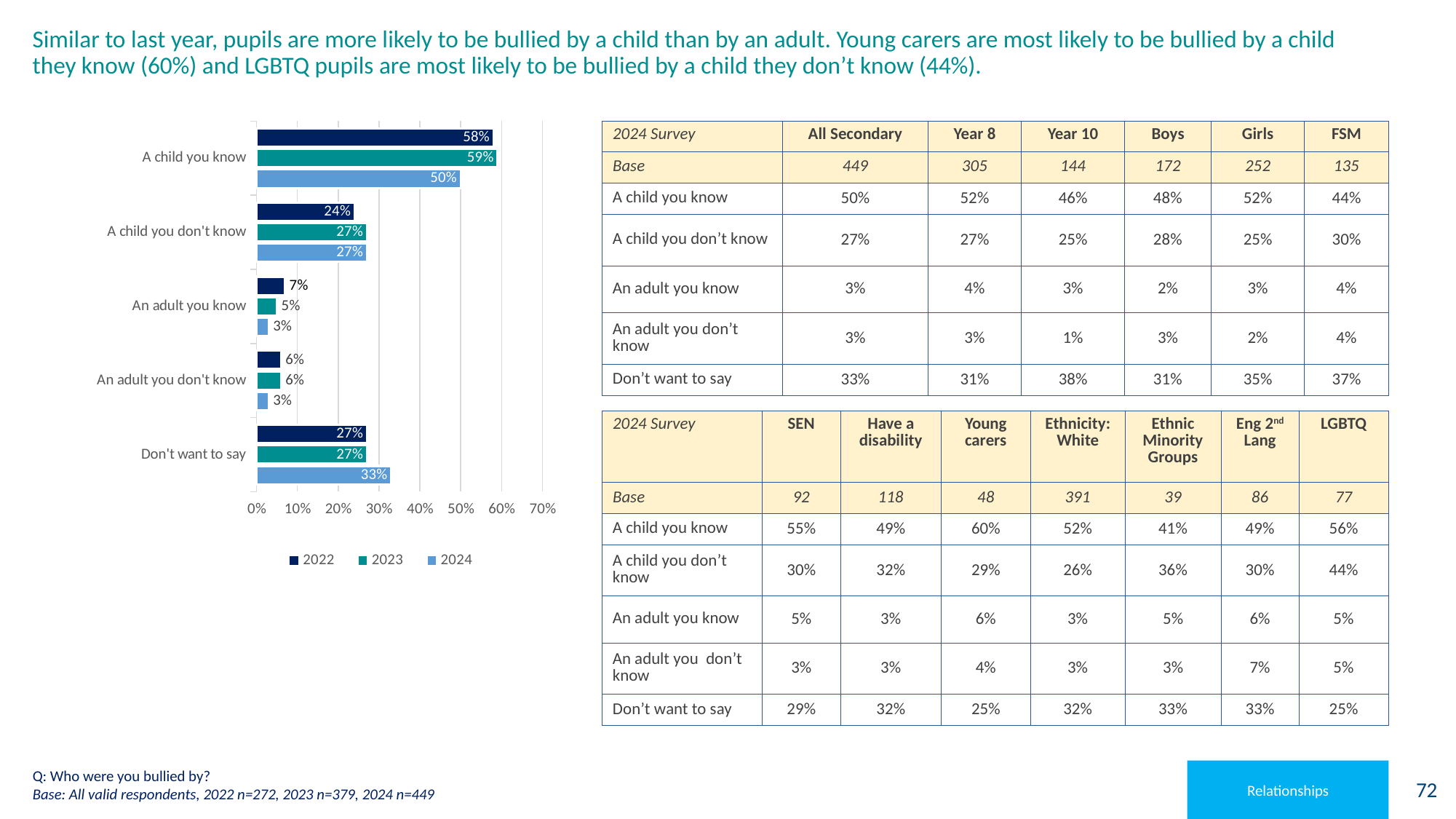
What is the 2024 value for 'A child you know' in the chart? 50% What kind of chart is shown on the slide? bar chart Which series is shown in the lightest blue colour in the chart? 2024 What is the difference between the 2023 and 2024 values for 'A child you know'? 9% What is the 2024 value for 'Don't want to say' in the chart? 33% What is the 2023 value for 'A child you know' in the chart? 59% What is the 2022 value for 'A child you don't know' in the chart? 24% Which is larger for 'An adult you know': the 2022 value or the 2024 value? 2022 How many categories are shown on the chart? 5 Which category has the highest 2022 value in the chart? A child you know Which category has the lowest 2022 value in the chart? An adult you don't know How many series does the chart legend list? 3